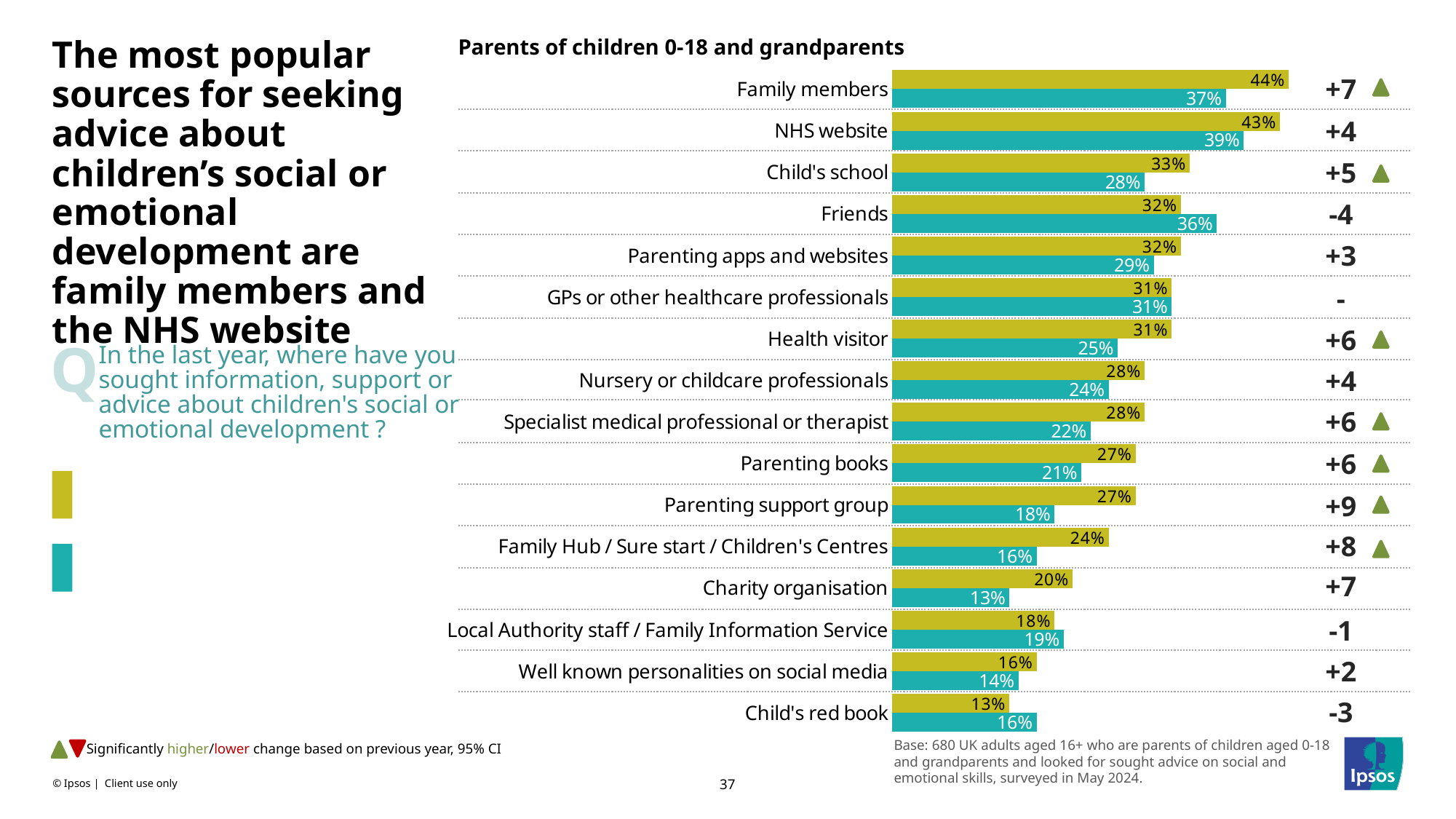
For Friends, which bar is larger, the yellow bar or the teal bar? the teal bar What is the difference between the yellow bar values for Charity organisation and Child's red book? 7 percentage points Which category has the lowest yellow bar value? Child's red book What is the value of the teal bar for NHS website? 39% What is the difference between the yellow and teal bar values for Family Hub / Sure start / Children's Centres? 8 percentage points How many categories (sources of advice) are listed in the chart? 16 Which category has the highest yellow bar value? Family members What is the value of the yellow bar for GPs or other healthcare professionals? 31% What is the title of the chart? Parents of children 0-18 and grandparents What is the value of the yellow bar for Family members? 44% What is the value of the teal bar for Parenting support group? 18% What kind of chart is shown on the slide? bar chart